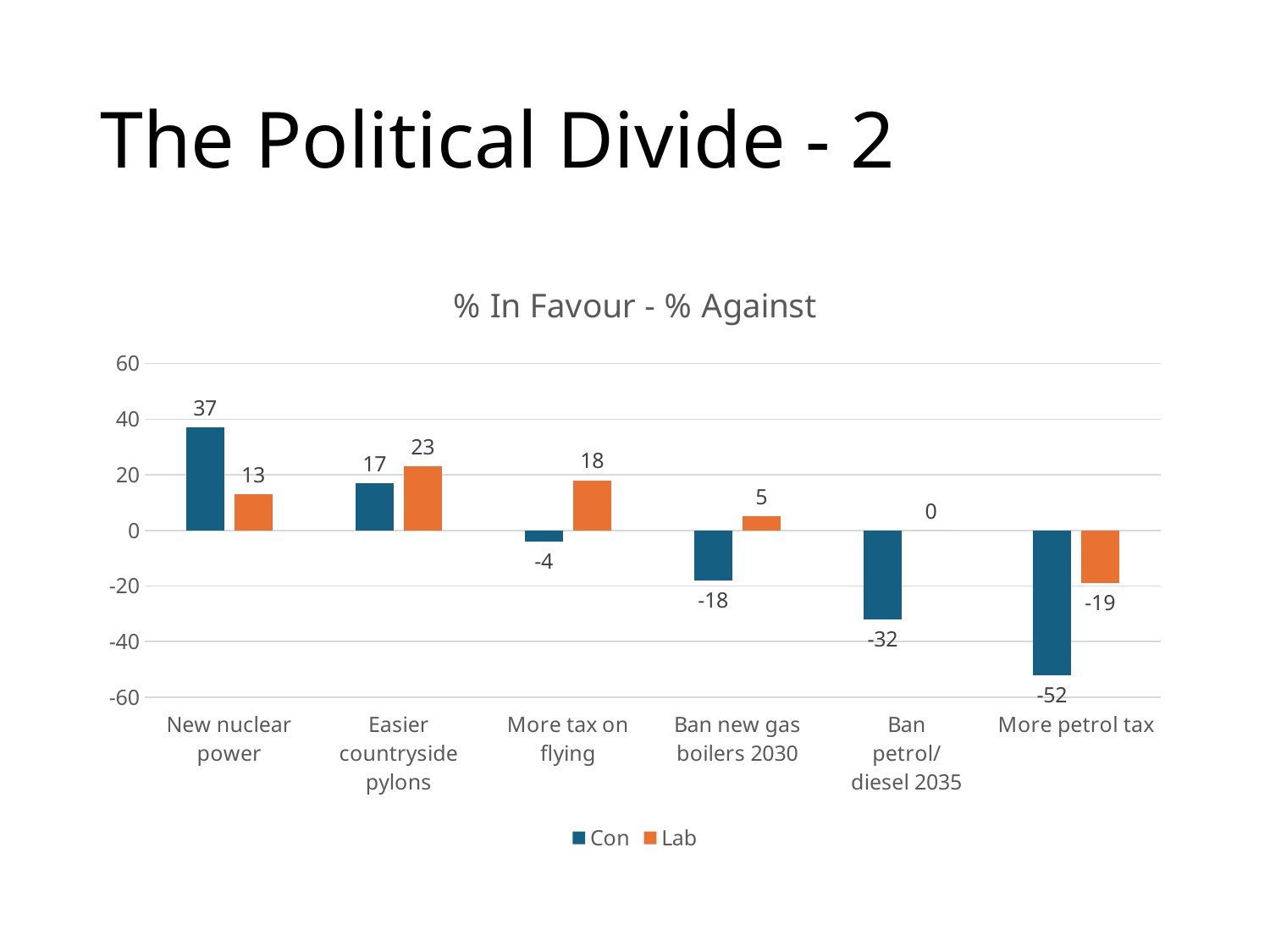
Which category has the highest Con value? New nuclear power What is the Lab value for Ban petrol/diesel 2035? 0 How many categories are shown on the x axis? 6 What is the Con value for New nuclear power? 37 Which is larger for More tax on flying, the Con value or the Lab value? Lab What is the Lab value for Easier countryside pylons? 23 What is the title of the chart? % In Favour - % Against What kind of chart is shown? Bar chart What is the difference between the Con and Lab values for New nuclear power? 24 How many series does the legend list? 2 Which category has the lowest Lab value? More petrol tax What is the Con value for More petrol tax? -52